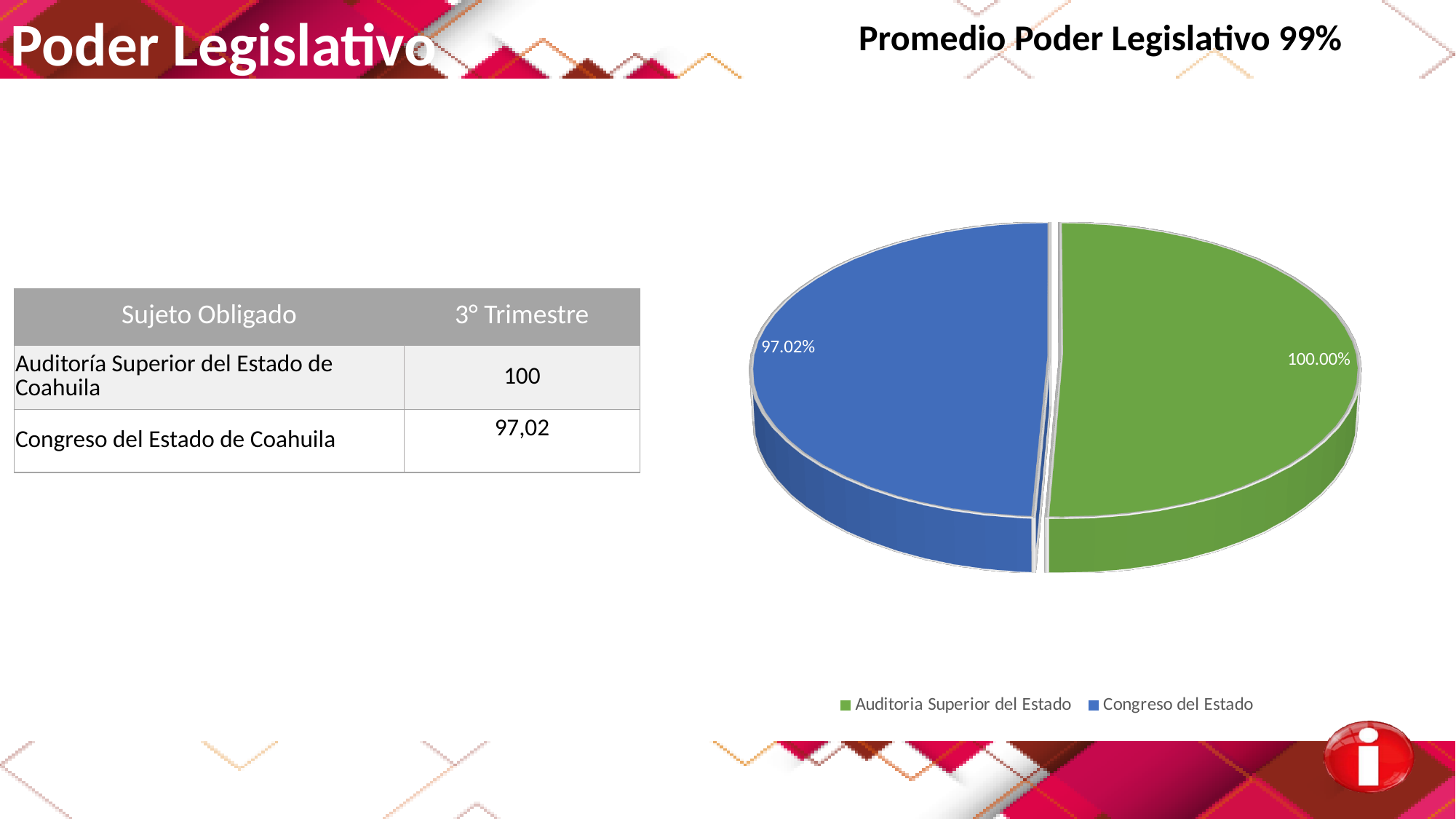
Which has the larger labelled value, Auditoria Superior del Estado or Congreso del Estado? Auditoria Superior del Estado Which category in the pie chart has the highest labelled value? Auditoria Superior del Estado What value is labelled on the pie slice for Congreso del Estado? 97.02% What colour is the slice for Auditoria Superior del Estado in the pie chart? green What colour is the slice for Congreso del Estado in the pie chart? blue Which category in the pie chart has the lowest labelled value? Congreso del Estado How many slices does the pie chart have? 2 What is the difference between the labelled values for Auditoria Superior del Estado and Congreso del Estado? 2.98% What kind of chart is shown on the slide? pie chart How many entries does the chart legend list? 2 What value is labelled on the pie slice for Auditoria Superior del Estado? 100.00%